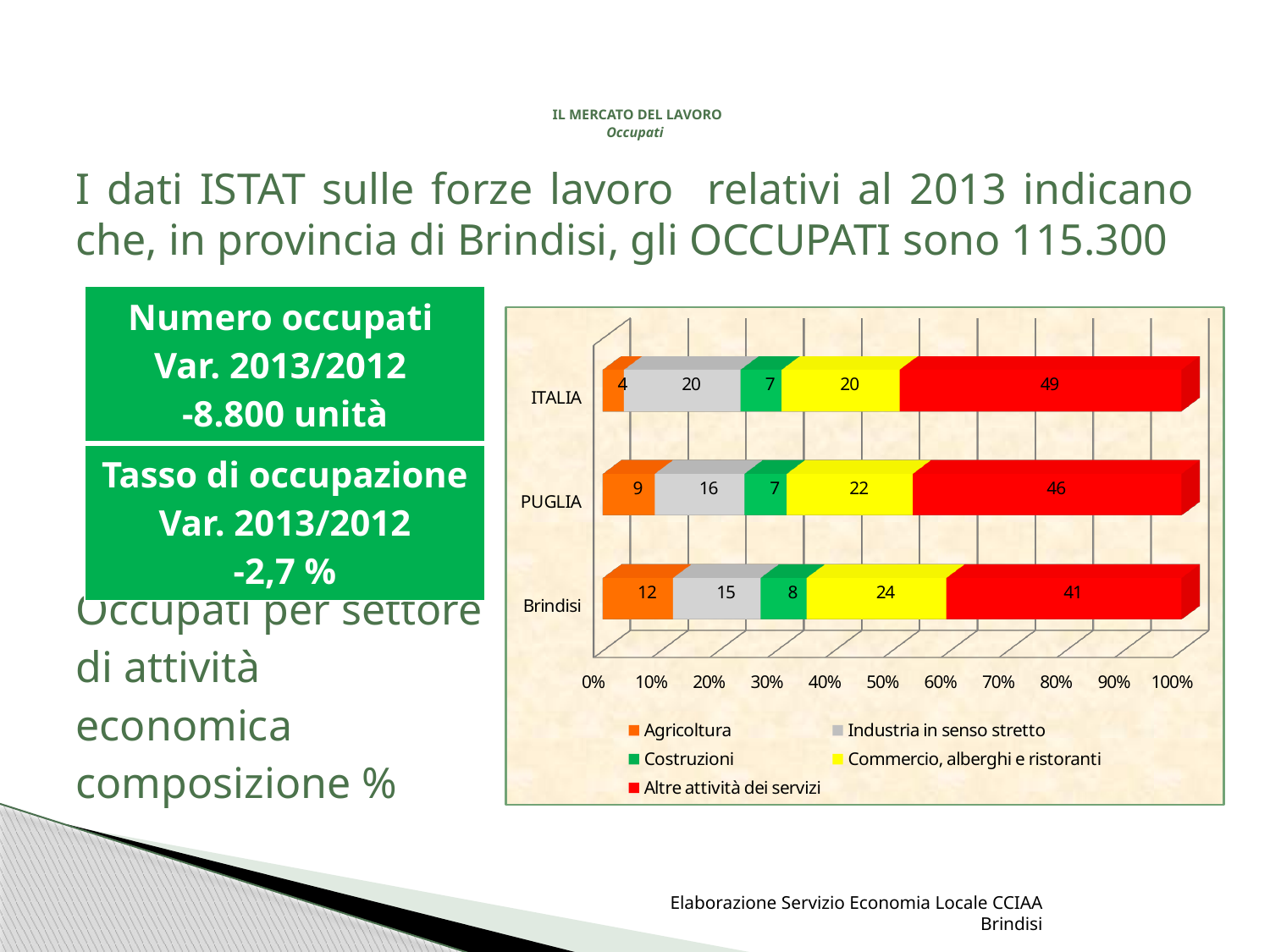
Which category has the highest value for Agricoltura? Brindisi What is the value for Commercio, alberghi e ristoranti for PUGLIA? 22 What is the total of the stacked bar for PUGLIA? 100 Which category has the lowest value for Altre attività dei servizi? Brindisi What is the value for Agricoltura for Brindisi? 12 What is the value for Industria in senso stretto for ITALIA? 20 How many series does the legend list? 5 Which is larger: the Industria in senso stretto value for PUGLIA or for Brindisi? PUGLIA What kind of chart is shown on the slide? Stacked bar chart What is the value for Altre attività dei servizi for ITALIA? 49 What is the difference between the Altre attività dei servizi values for ITALIA and Brindisi? 8 How many categories are shown on the y axis of the chart? 3